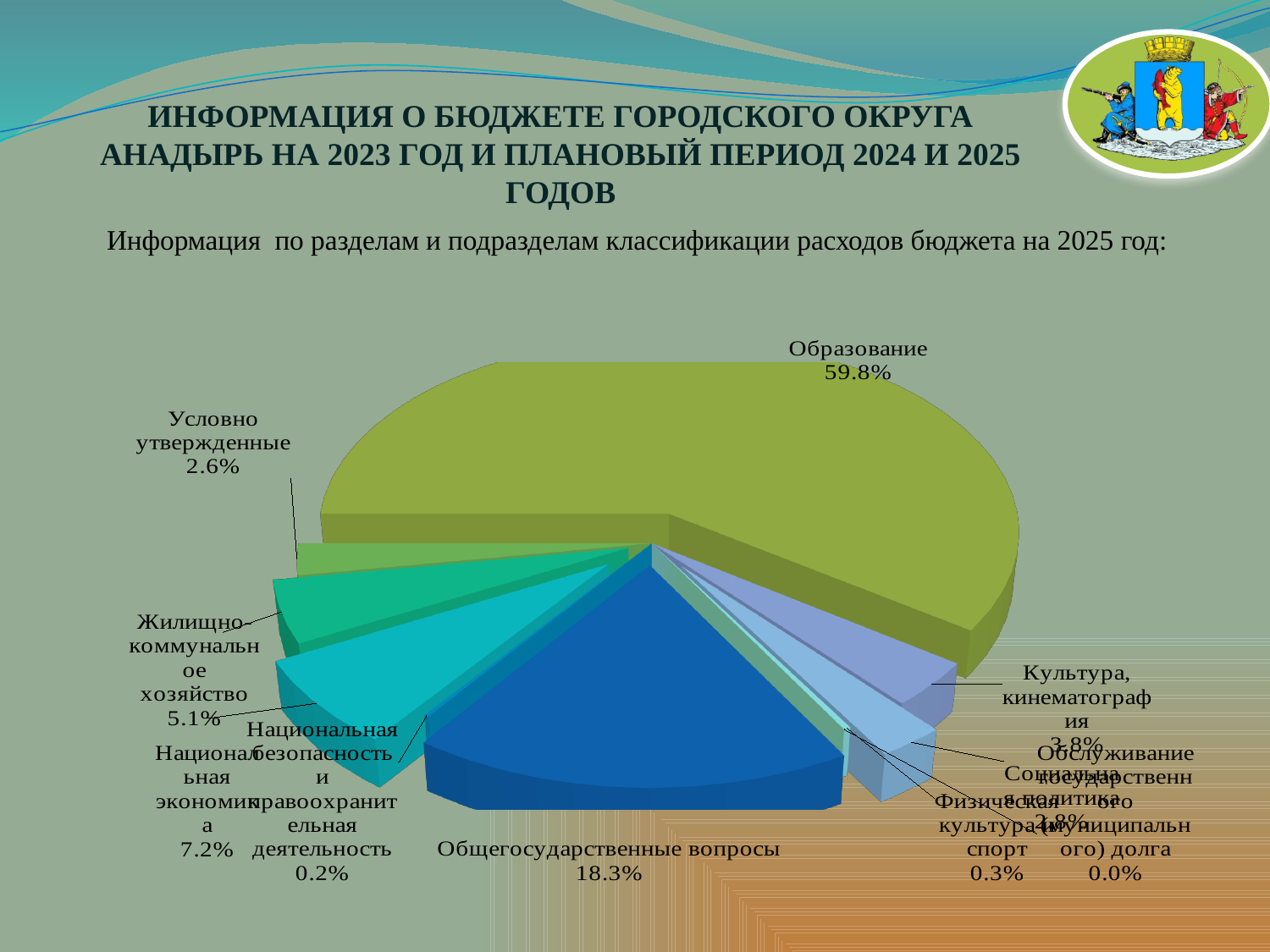
What share of the budget expenditure does Образование account for? 59.8% What is the value for Жилищно-коммунальное хозяйство? 5.1% Which is larger: Национальная экономика or Жилищно-коммунальное хозяйство? Национальная экономика What percentage is labelled for Условно утвержденные? 2.6% For which year does the chart show the breakdown of budget expenditure? 2025 Which category has the largest slice of the pie? Образование What is the value shown for Физическая культура и спорт? 0.3% By how many percentage points does Образование exceed Общегосударственные вопросы? 41.5 percentage points What is the value shown for Общегосударственные вопросы? 18.3% Which category has the smallest value in the chart? Обслуживание государственного (муниципального) долга What percentage is shown for Национальная экономика? 7.2% What kind of chart is shown on the slide? Pie chart